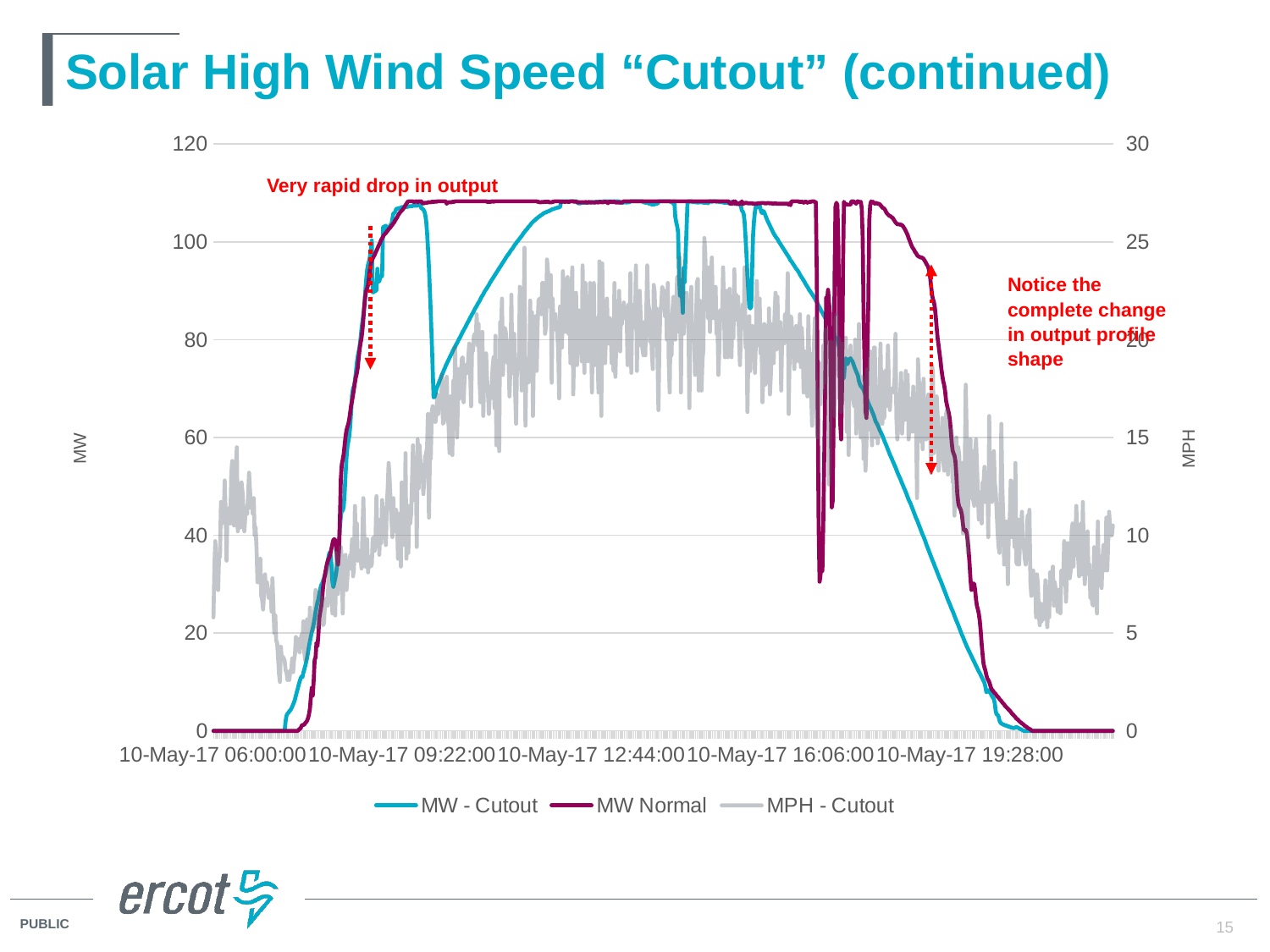
What is the highest tick value shown on the right vertical axis? 30 Is the peak value of the MW Normal series greater or less than 100? greater Is the peak value of the MPH - Cutout series greater or less than 20 MPH? greater How many date-time labels are shown on the x axis? 5 What is the highest tick value shown on the left vertical axis? 120 Is the value of MW - Cutout at 10-May-17 06:00:00 greater or less than 20? less What is the label on the right vertical axis? MPH What are the three series listed in the legend? MW - Cutout, MW Normal, MPH - Cutout Does the MW - Cutout series rise or fall between 10-May-17 16:06:00 and 10-May-17 19:28:00? fall How many series does the legend list? 3 Does the MW Normal series rise or fall between 10-May-17 06:00:00 and 10-May-17 09:22:00? rise What type of chart is shown on the slide? line chart